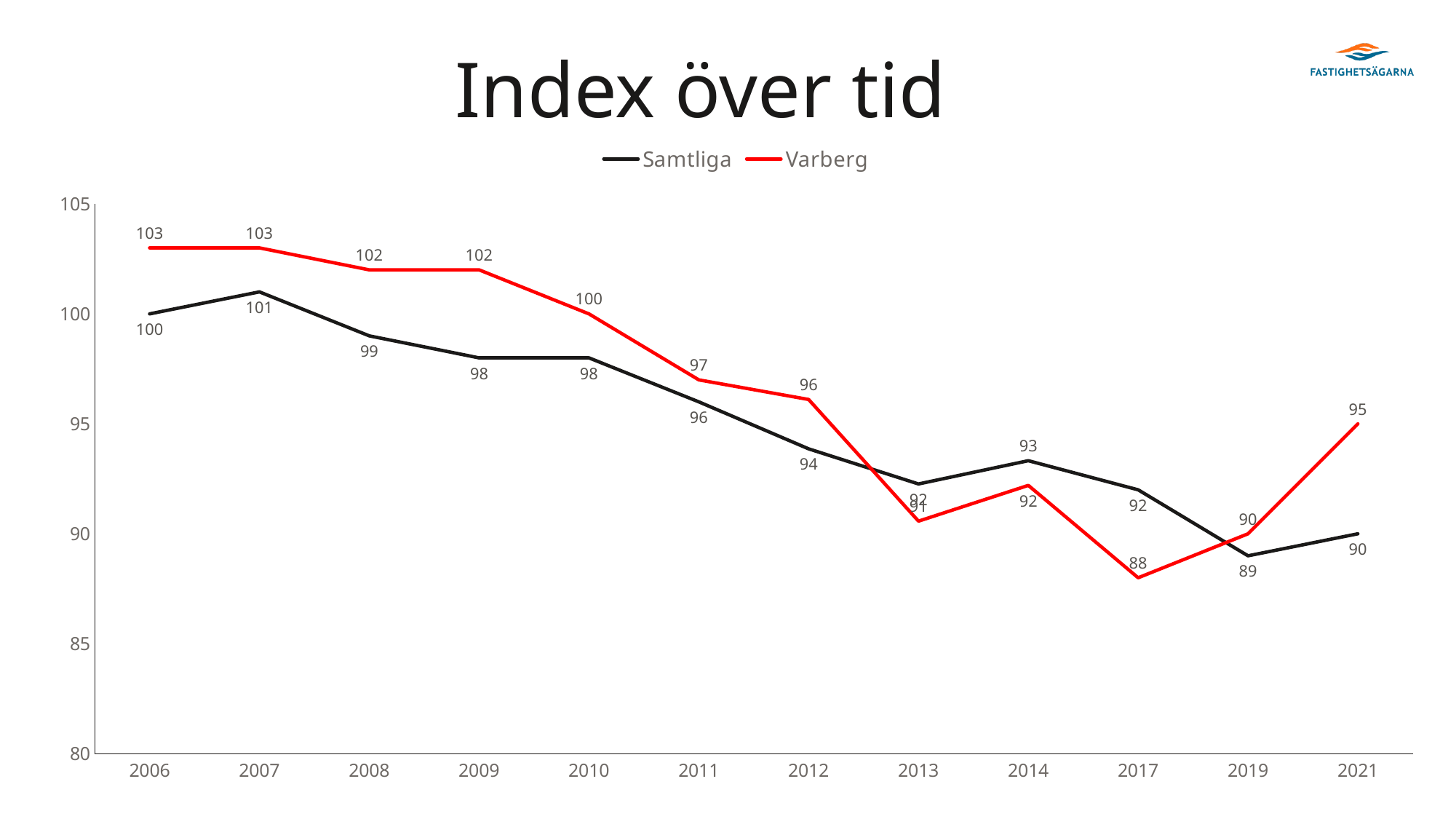
What is the difference between the Varberg and Samtliga values in 2021? 5 What is the Samtliga index value for 2019? 89 What colour is the Varberg line? red In which year does the Varberg series reach its lowest value? 2017 What is the Varberg index value for 2017? 88 In which year does the Samtliga series reach its highest value? 2007 How many series does the legend list? 2 What kind of chart is shown on the slide? line chart In 2017, which series has the higher value, Samtliga or Varberg? Samtliga What is the Varberg index value for 2006? 103 Does the Samtliga series generally rise or fall from 2006 to 2019? fall How many years are plotted along the x axis? 12